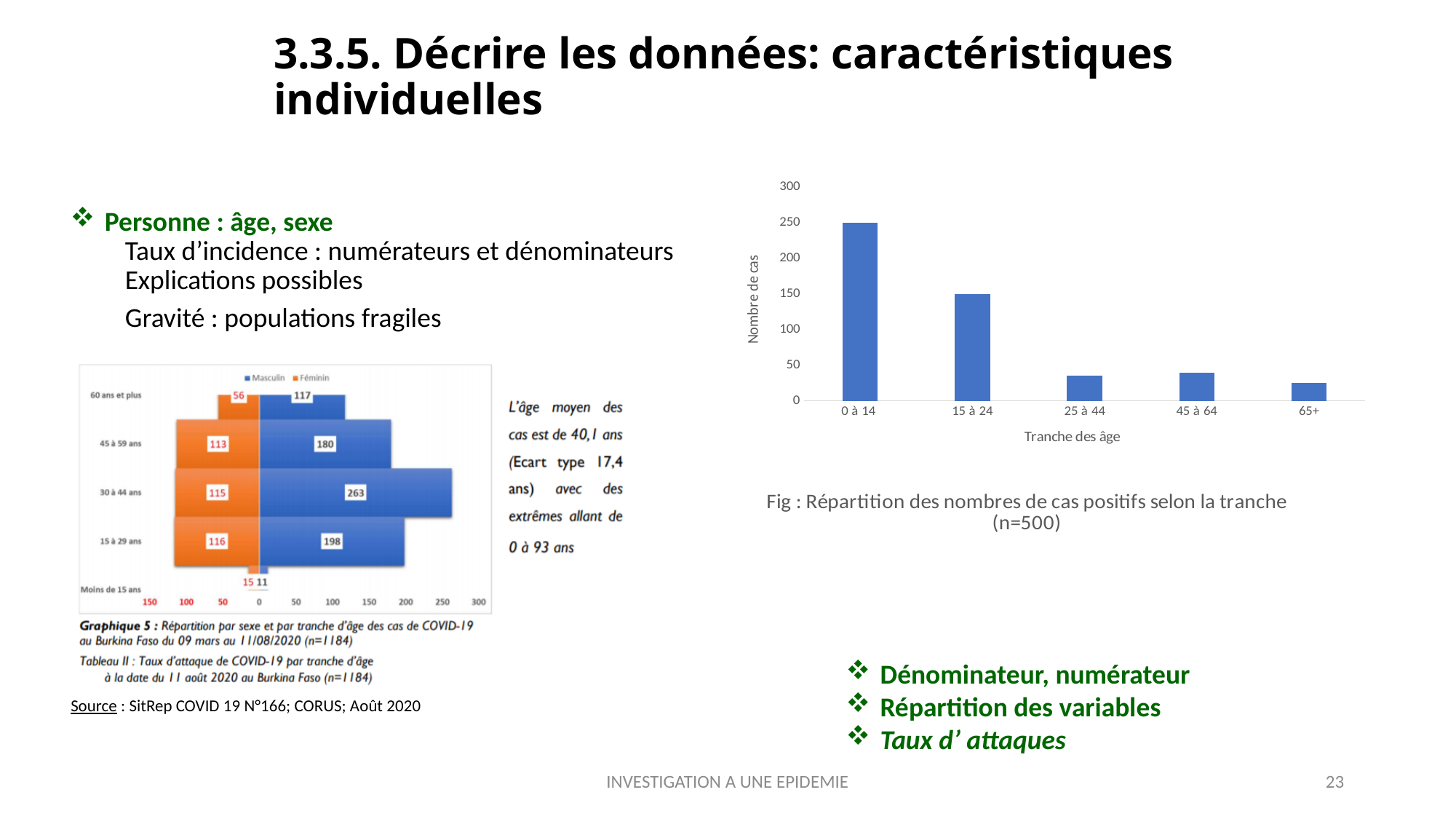
In the chart titled 'Répartition des nombres de cas positifs selon la tranche (n=500)', how many age groups are shown on the x axis? 5 In the chart 'Graphique 5' on the left of the slide, what is the difference between the Masculin and Féminin values for 45 à 59 ans? 67 In the chart titled 'Répartition des nombres de cas positifs selon la tranche (n=500)', is the value for 25 à 44 greater or less than 50? less In the chart titled 'Répartition des nombres de cas positifs selon la tranche (n=500)', which is larger, the value for 0 à 14 or the value for 15 à 24? 0 à 14 In the chart 'Graphique 5' on the left of the slide, what is the Féminin value for 15 à 29 ans? 116 In the chart titled 'Répartition des nombres de cas positifs selon la tranche (n=500)', is the value for 15 à 24 greater or less than 100? greater In the chart titled 'Répartition des nombres de cas positifs selon la tranche (n=500)', which age group has the highest number of cases? 0 à 14 In the chart 'Graphique 5' on the left of the slide, which age group has the highest Masculin value? 30 à 44 ans In the chart 'Graphique 5' on the left of the slide, what is the Masculin value for 30 à 44 ans? 263 In the chart titled 'Répartition des nombres de cas positifs selon la tranche (n=500)', what is the label of the y axis? Nombre de cas In the chart 'Graphique 5' on the left of the slide, which is larger for 60 ans et plus, the Masculin value or the Féminin value? Masculin In the chart 'Graphique 5' on the left of the slide, how many series does the legend list? 2